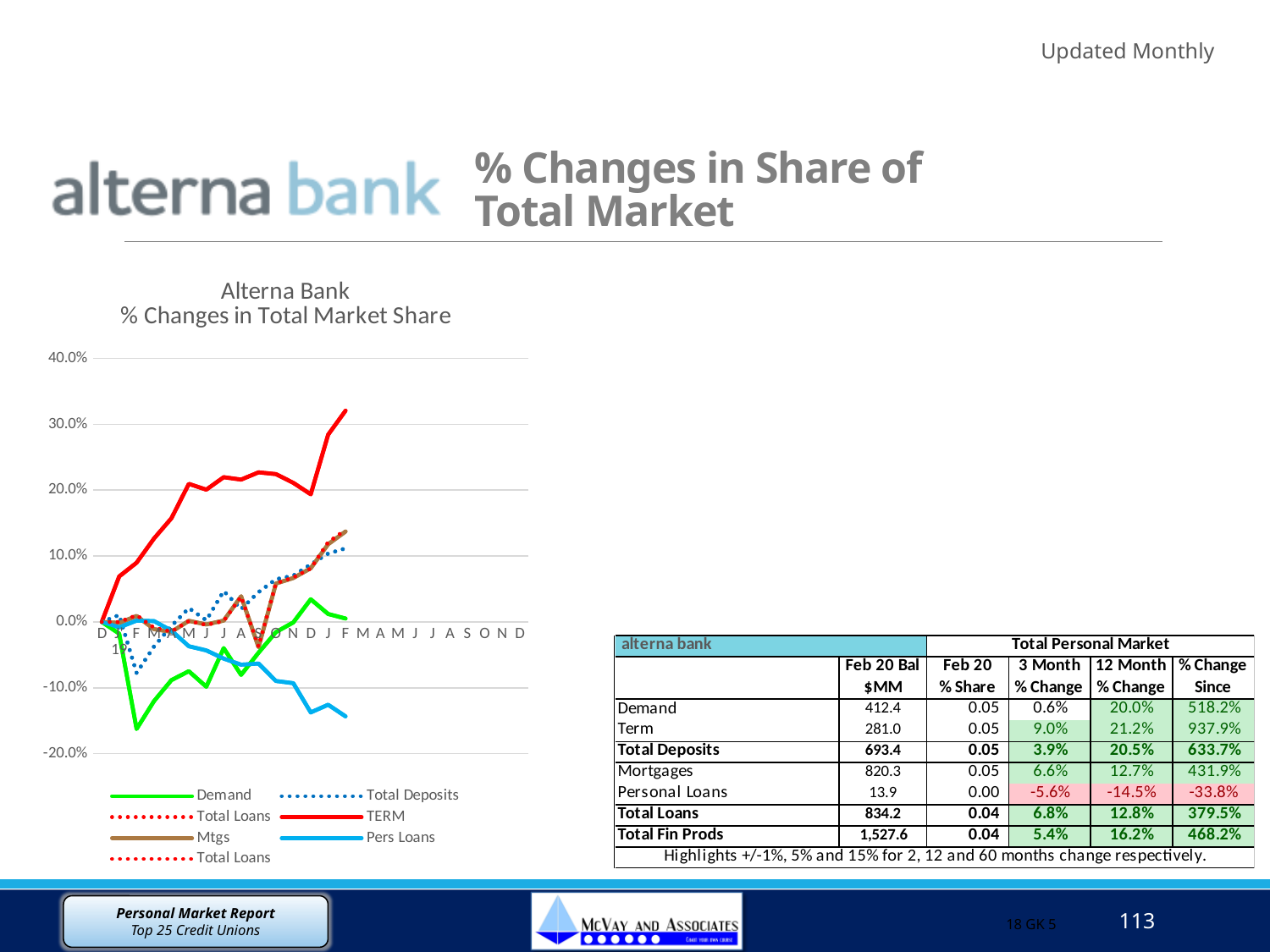
Is the final value of the Pers Loans line greater or less than -10.0%? less What kind of chart is shown on the slide? line chart Does the Pers Loans line generally rise or fall from left to right? fall Does the TERM line generally rise or fall from left to right? rise Is the lowest point of the Demand line greater or less than -10.0%? less Which series reaches the highest value on the chart? TERM Is the final value of the Mtgs line greater or less than 10.0%? greater Which series ends at the lowest value at the right end of the chart? Pers Loans How many series does the chart legend list? 7 What is the title of the chart? Alterna Bank % Changes in Total Market Share At the right end of the chart, which is higher: the TERM line or the Demand line? TERM